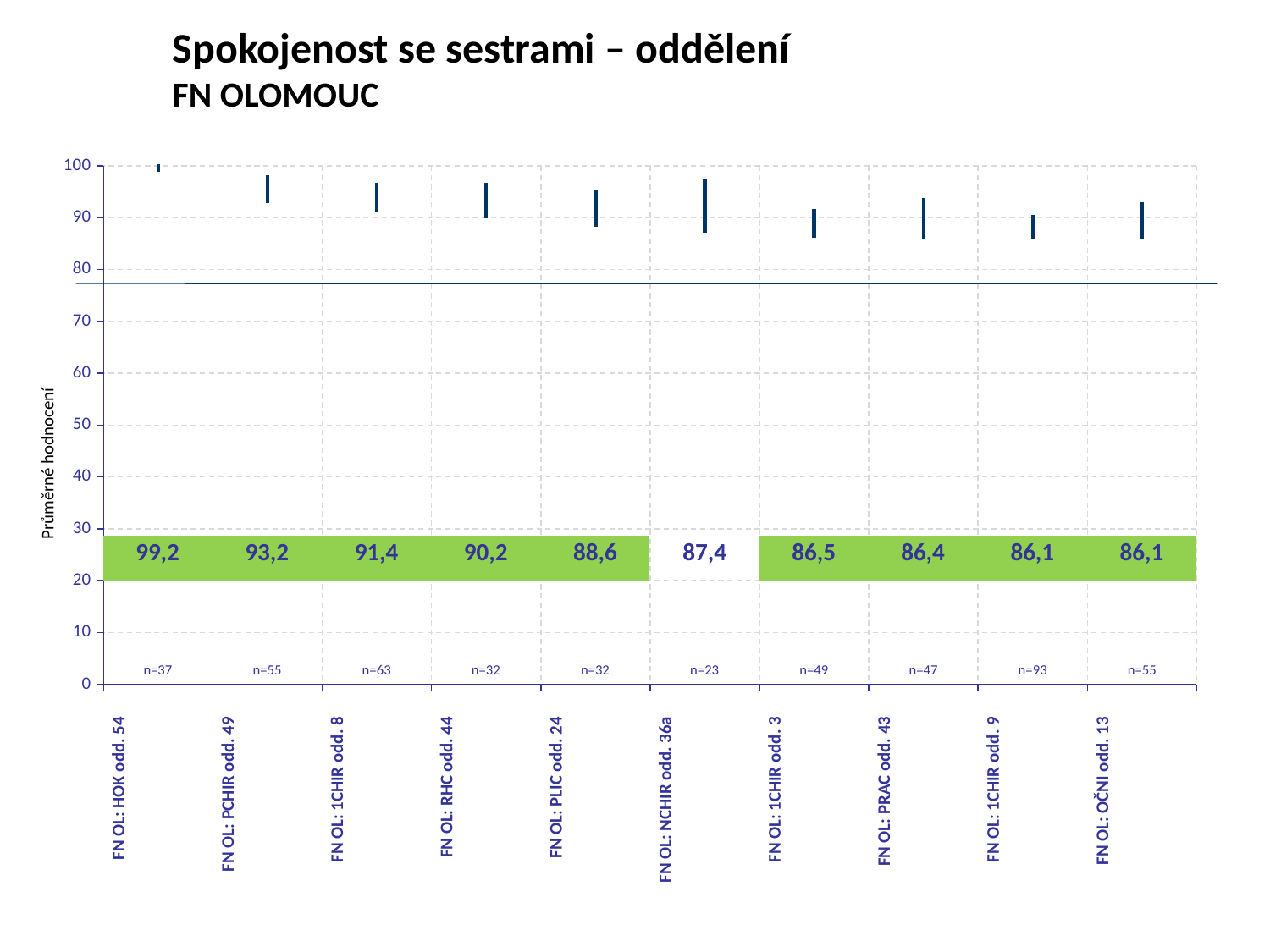
What is the label of the vertical axis? Průměrné hodnocení What is the number of respondents (n) for FN OL: 1CHIR odd. 9? n=93 What is the difference between the average ratings of FN OL: HOK odd. 54 and FN OL: PCHIR odd. 49? 6,0 Which has a higher average rating, FN OL: PRAC odd. 43 or FN OL: 1CHIR odd. 3? FN OL: 1CHIR odd. 3 What is the average rating for FN OL: NCHIR odd. 36a? 87,4 What is the average rating for FN OL: HOK odd. 54? 99,2 How many departments are shown on the chart? 10 Do the average ratings rise or fall from left to right across the chart? fall What is the subtitle shown under the chart title? FN OLOMOUC What is the difference between the average ratings of FN OL: 1CHIR odd. 8 and FN OL: PLIC odd. 24? 2,8 What is the average rating for FN OL: RHC odd. 44? 90,2 Which department has the highest average rating? FN OL: HOK odd. 54